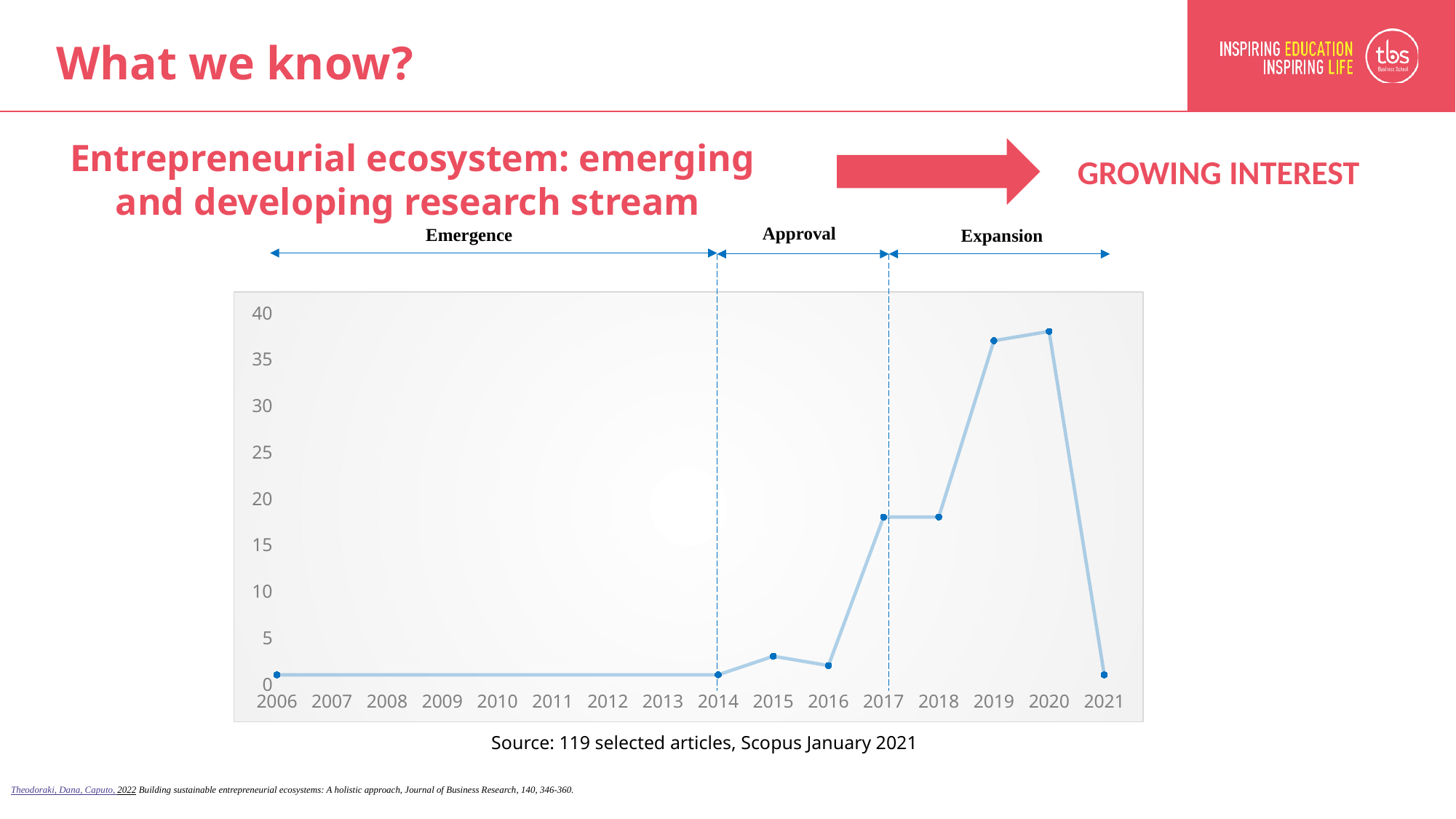
What are the three phases labelled above the chart, from left to right? Emergence, Approval, Expansion Is the value for 2020 greater or less than 35? greater Is the value for 2017 greater or less than 15? greater What kind of chart is shown on the slide? line chart Do the values rise or fall from 2020 to 2021? fall Is the value for 2017 greater or less than 20? less How many year labels are shown on the x axis of the chart? 16 Do the values rise or fall from 2016 to 2019? rise Which is larger, the value for 2019 or the value for 2017? 2019